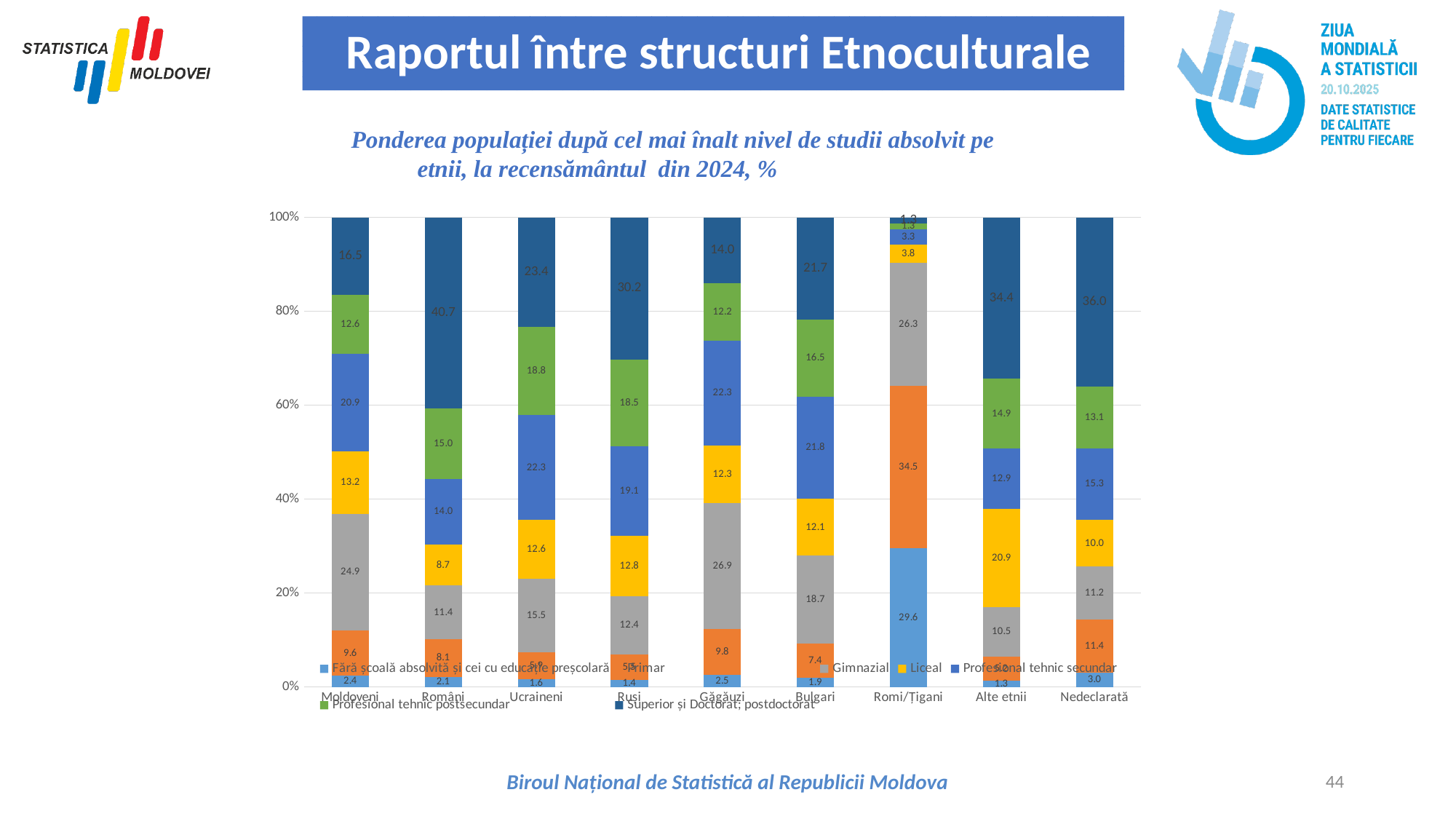
What is the value of the 'Superior și Doctorat; postdoctorat' segment for Români? 40.7 How many series does the legend list? 7 What is the value of the 'Liceal' segment for Alte etnii? 20.9 How many ethnic groups (categories) are shown on the x axis? 9 Which is larger: the 'Liceal' value for Alte etnii or for Moldoveni? Alte etnii Which ethnic group has the lowest value for 'Superior și Doctorat; postdoctorat'? Romi/Țigani What is the value of the 'Fără școală absolvită și cei cu educație preșcolară' segment for Romi/Țigani? 29.6 Which ethnic group has the highest value for 'Superior și Doctorat; postdoctorat'? Români What is the value of the 'Gimnazial' segment for Găgăuzi? 26.9 What kind of chart is shown on the slide? Stacked bar chart What is the value of the 'Primar' segment for Romi/Țigani? 34.5 What is the difference between the 'Superior și Doctorat; postdoctorat' values for Nedeclarată and Alte etnii? 1.6